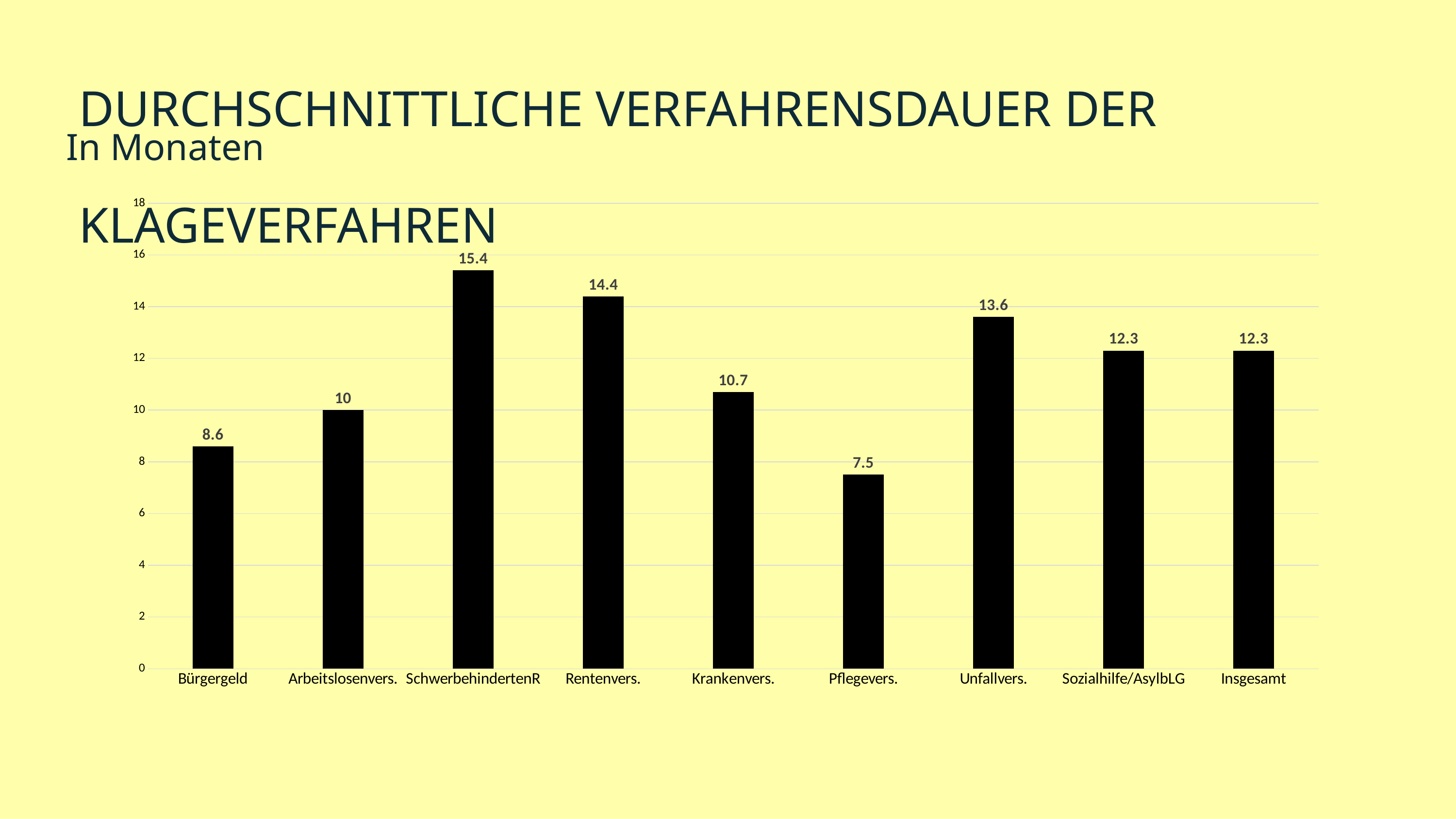
What is the difference between the values for SchwerbehindertenR and Pflegevers.? 7.9 What value is shown for Rentenvers.? 14.4 Which is larger, the value for Arbeitslosenvers. or the value for Krankenvers.? Krankenvers. What is the value for Pflegevers.? 7.5 How many categories are shown on the x axis? 9 What kind of chart is shown on the slide? bar chart What is the difference between Unfallvers. and Krankenvers.? 2.9 Which category has the lowest average duration? Pflegevers. Which category has the highest average duration? SchwerbehindertenR What unit does the subtitle say the values are in? Monaten What is the value shown for Insgesamt? 12.3 What is the average duration in months for Bürgergeld? 8.6